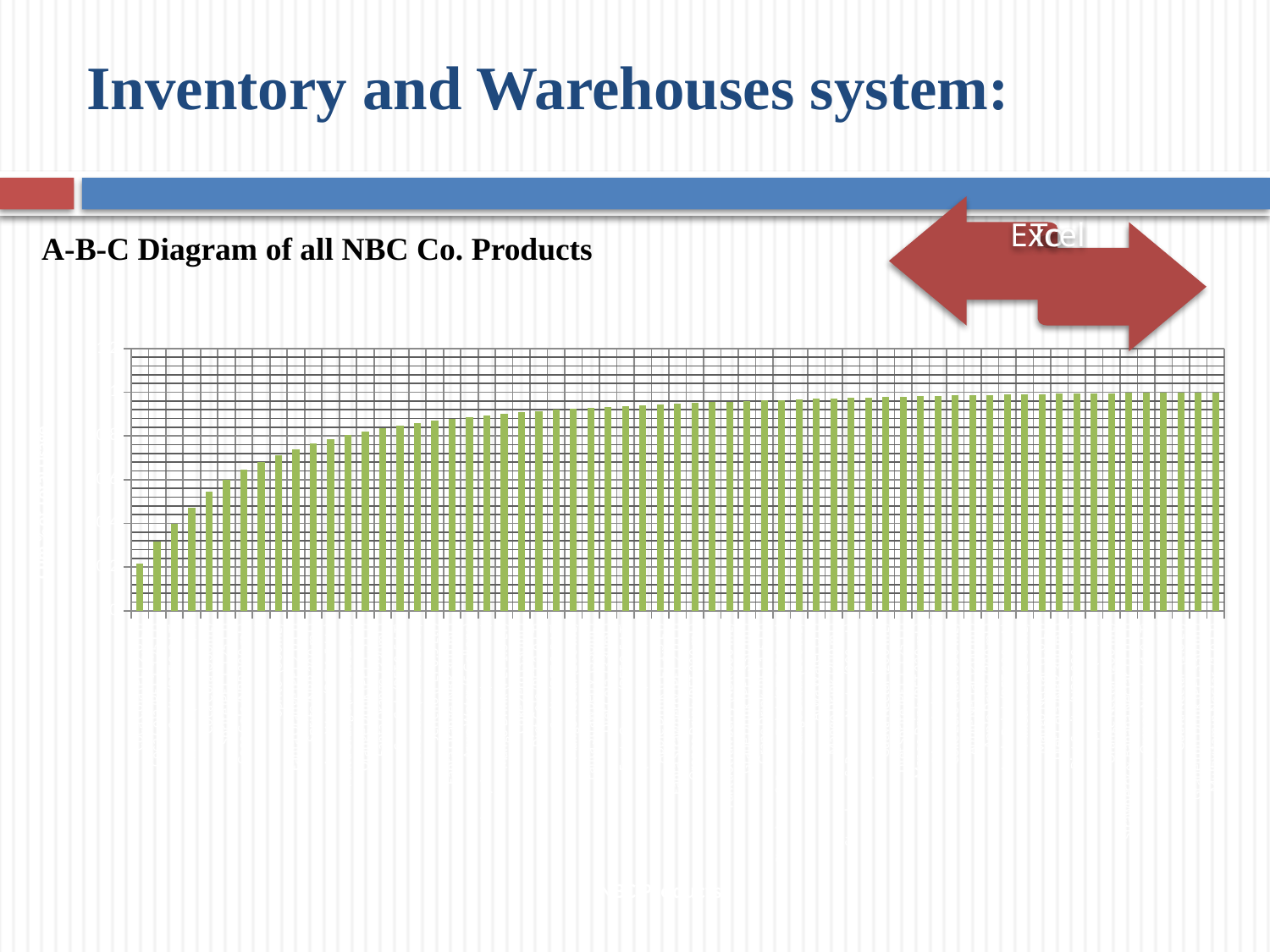
What colour are the bars in the chart? green Do the bar values rise or fall from left to right along the x axis? rise What kind of chart is shown on the slide? bar chart What is the title given above the chart on the slide? A-B-C Diagram of all NBC Co. Products